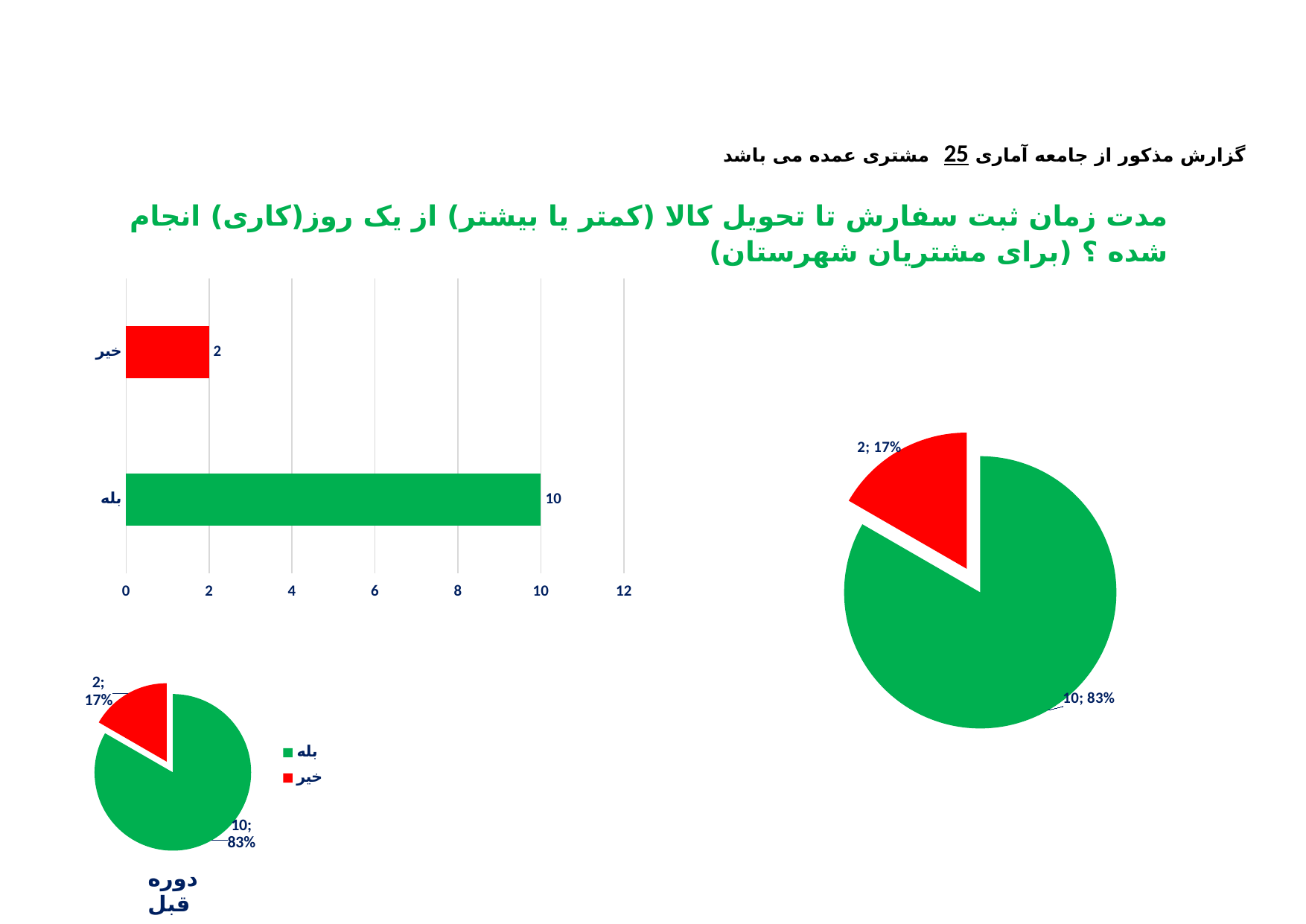
In the bar chart on the top left, what is the value for خیر? 2 In the bar chart on the top left, what is the difference between the values for بله and خیر? 8 How many entries does the legend next to the small pie chart at the bottom left list? 2 In the bar chart on the top left, which category has the highest value? بله In the small pie chart labelled دوره قبل at the bottom left, what is the value and share of the red slice? 2; 17% In the large pie chart on the right, what share does the green slice (بله) have? 83% What kind of chart is shown on the top left of the slide? bar chart In the bar chart on the top left, which category has the lowest value? خیر In the bar chart on the top left, what is the value for بله? 10 In the large pie chart on the right, what share does the red slice (خیر) have? 17% What colour is the بله slice in the pie charts? green In the bar chart on the top left, how many categories are shown? 2